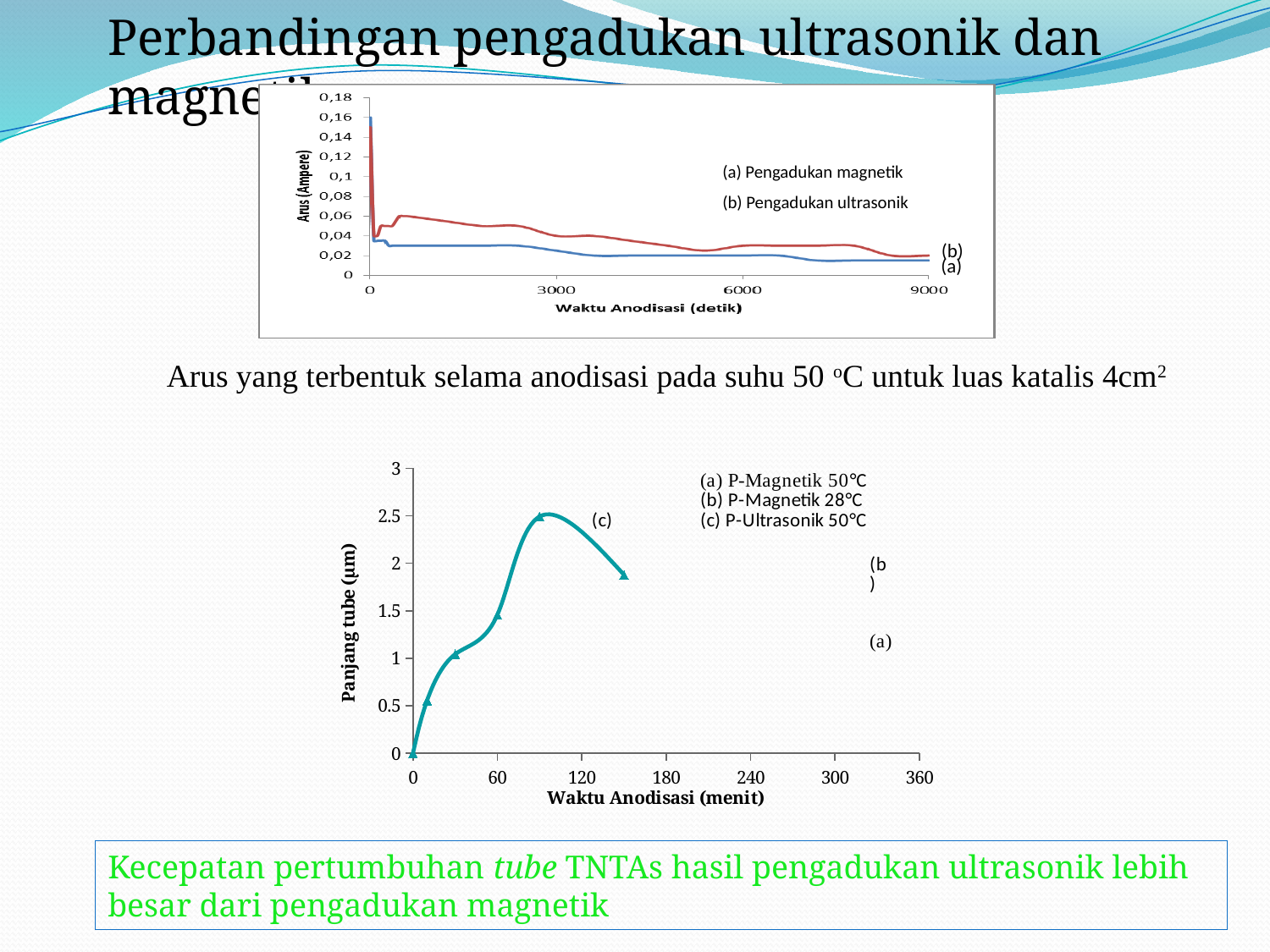
What kind of chart is the bottom chart (Panjang tube vs Waktu Anodisasi)? line chart In the bottom chart, is the value for (c) P-Ultrasonik 50°C at 90 menit greater or less than 2? greater In the top chart, is the value for (b) Pengadukan ultrasonik at 6000 detik greater or less than 0,04? less In the top chart, how many series does the legend list? 2 In the top chart, which series has the higher current at 3000 detik, (a) Pengadukan magnetik or (b) Pengadukan ultrasonik? (b) Pengadukan ultrasonik In the bottom chart, how many series does the legend list? 3 In the top chart, is the value for (a) Pengadukan magnetik at 9000 detik greater or less than 0,02? less What kind of chart is the top chart (Arus vs Waktu Anodisasi)? line chart In the bottom chart, what is the label of the x axis? Waktu Anodisasi (menit) In the top chart, do the current values generally rise or fall as anodization time increases? fall In the top chart, what is the label of the y axis? Arus (Ampere)